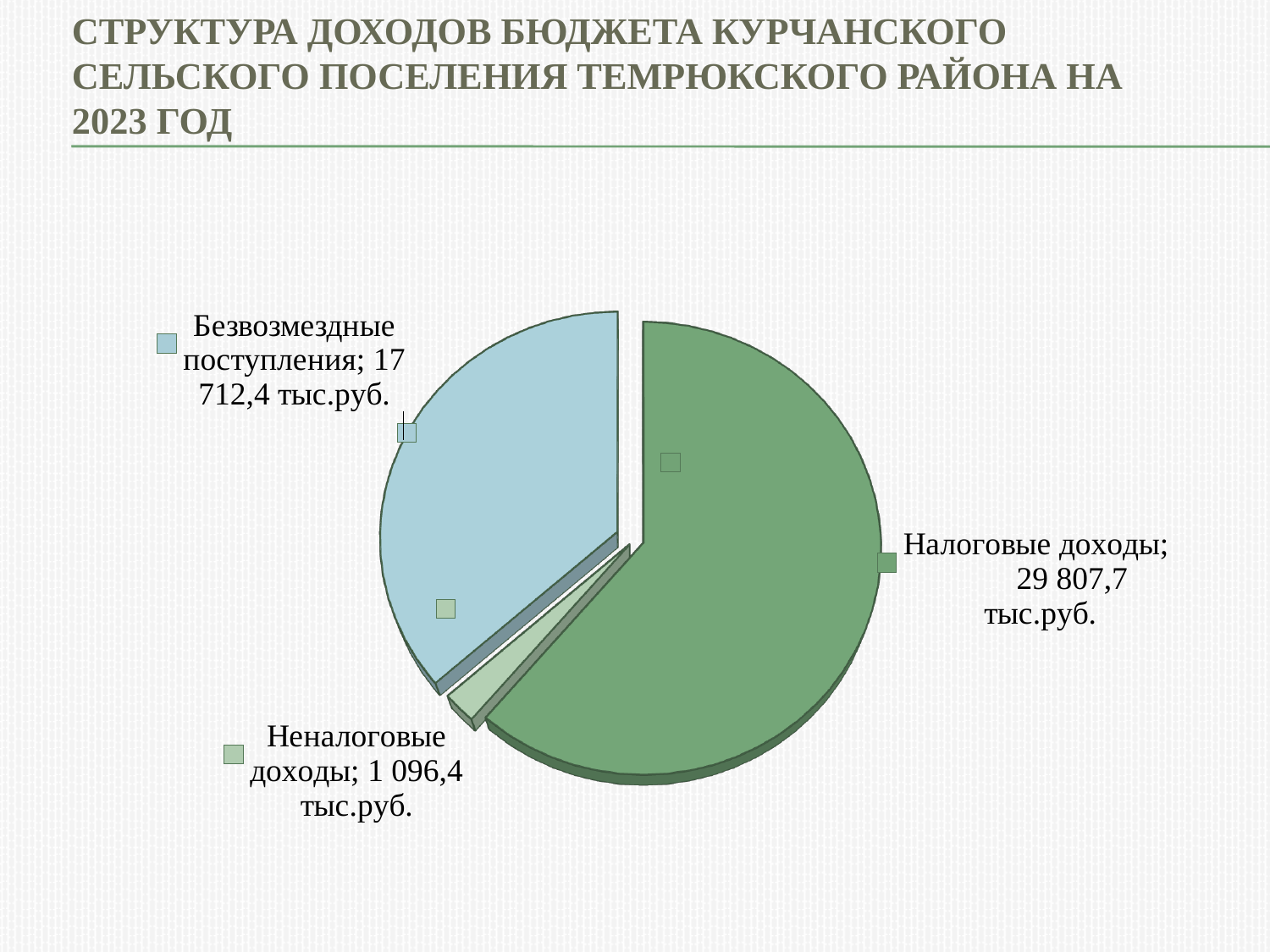
What is the value for Неналоговые доходы? 1 096,4 тыс.руб. What is the difference between Налоговые доходы and Безвозмездные поступления? 12 095,3 тыс.руб. How many slices does the pie chart have? 3 What is the total of all three categories in the pie chart? 48 616,5 тыс.руб. Which category has the smallest slice of the pie? Неналоговые доходы What is the value for Безвозмездные поступления? 17 712,4 тыс.руб. What type of chart is shown on the slide? pie chart What is the value for Налоговые доходы? 29 807,7 тыс.руб. Which is larger, Безвозмездные поступления or Неналоговые доходы? Безвозмездные поступления What is the difference between Безвозмездные поступления and Неналоговые доходы? 16 616,0 тыс.руб. What share of the total do Налоговые доходы represent? 61,3% Which category has the largest slice of the pie? Налоговые доходы